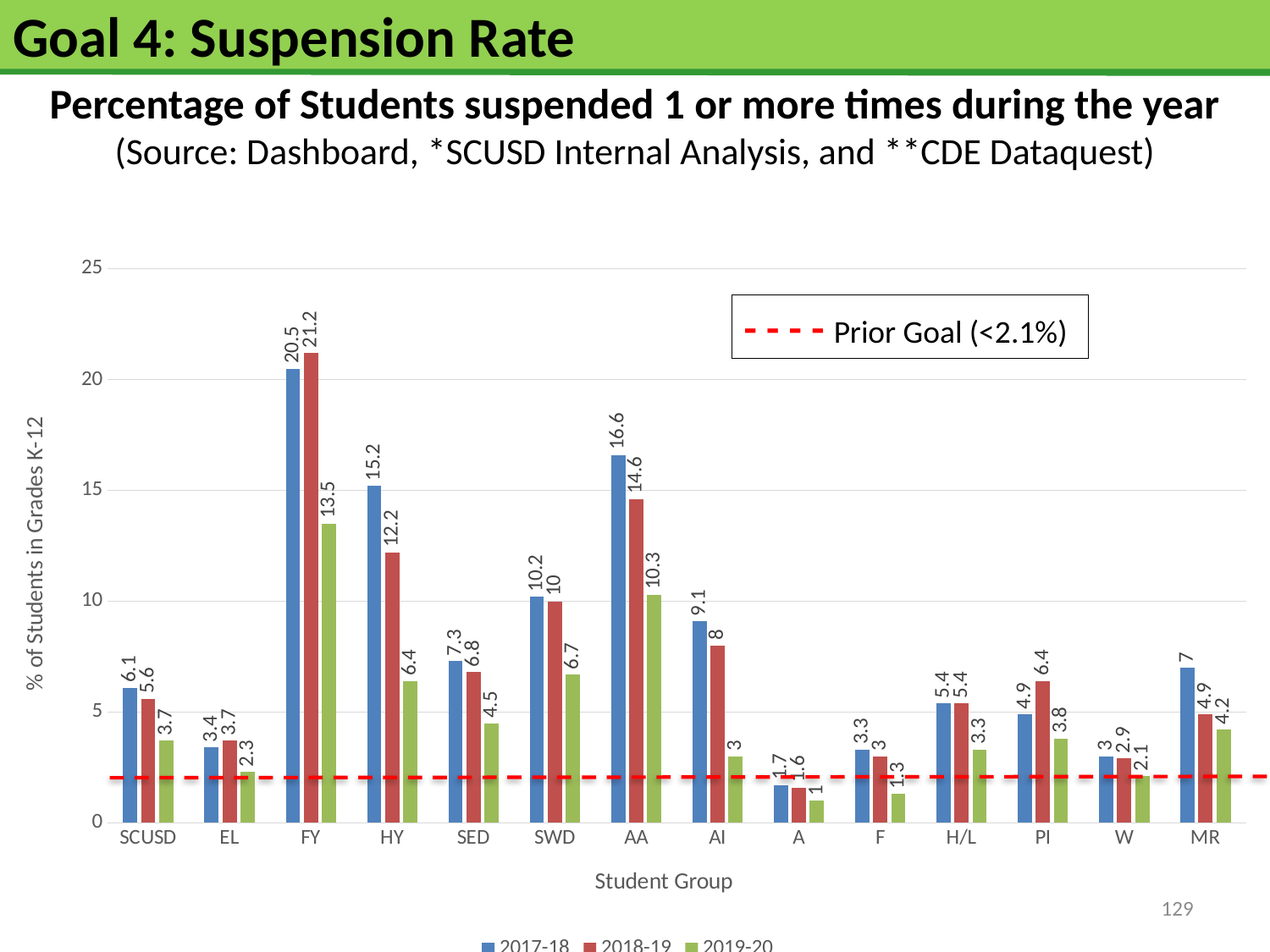
Which student group has the highest 2018-19 value? FY What is the 2018-19 value for PI? 6.4 What does the red dashed line on the chart represent? Prior Goal (<2.1%) What is the 2019-20 value for AA? 10.3 How many student groups are shown on the x axis? 14 How many series does the legend list for the bars? 3 What is the 2017-18 value for FY? 20.5 What kind of chart is shown on the slide? Bar chart Do the values for SCUSD rise or fall from 2017-18 to 2019-20? Fall What is the difference between the 2017-18 and 2019-20 values for HY? 8.8 Which is larger for MR: the 2017-18 value or the 2018-19 value? 2017-18 Which student group has the lowest 2019-20 value? A